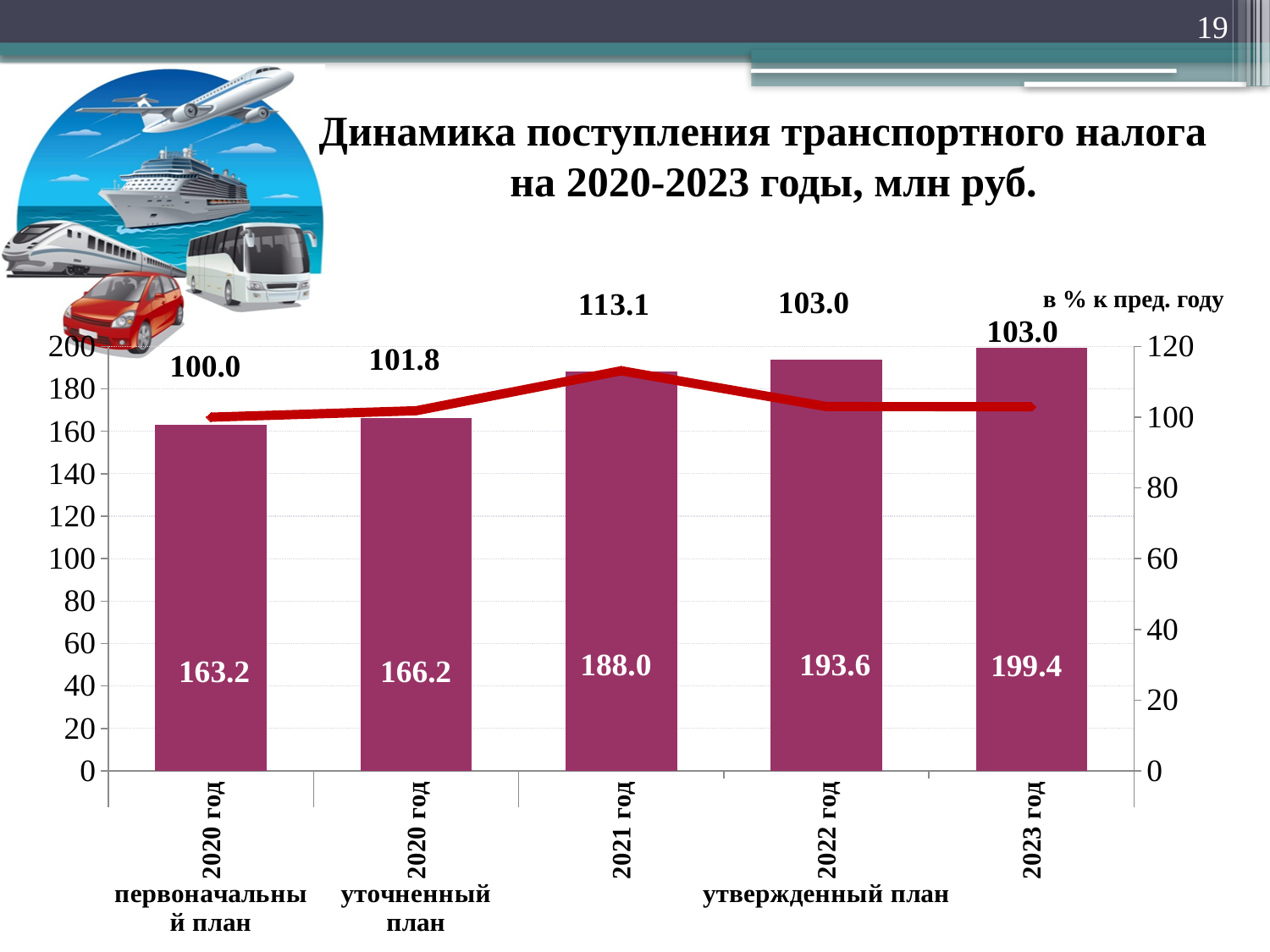
Which is larger, the bar value for 2021 год or for 2022 год? 2022 год What is the bar value for 2021 год? 188.0 What is the line value (в % к пред. году) shown above the 2021 год bar? 113.1 How many bars are plotted on the chart? 5 What is the transport tax revenue value shown for 2023 год? 199.4 Which category has the highest bar value? 2023 год What is the difference between the 2020 год уточненный план bar and the 2020 год первоначальный план bar? 3.0 Which category has the lowest bar value? 2020 год (первоначальный план) Do the bar values rise or fall from left to right across the chart? rise What is the difference between the bar values for 2023 год and 2022 год? 5.8 What is the bar value for 2020 год under the первоначальный план? 163.2 What is the title of the chart? Динамика поступления транспортного налога на 2020-2023 годы, млн руб.